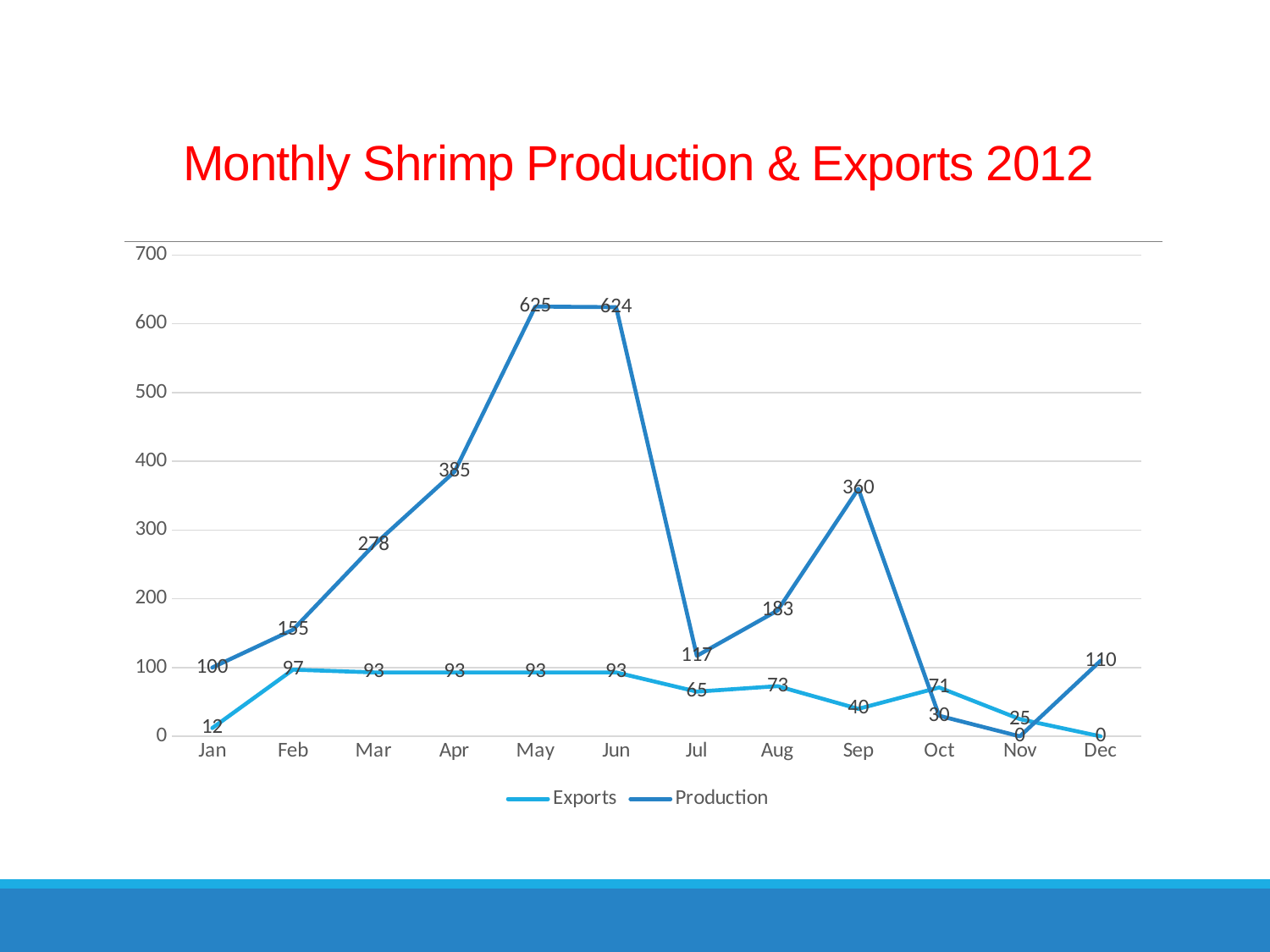
What is the Production value for May? 625 What is the Production value for December? 110 In October, which series has the larger value, Exports or Production? Exports In which month is Production lowest? Nov What kind of chart is shown on the slide? line chart What is the difference between Production in June and Production in July? 507 What is the difference between Production in May and Production in April? 240 What is the Exports value for September? 40 Is the Production value for April greater or less than 300? greater How many series does the legend list? 2 In which month is Exports lowest? Dec How many months are shown on the x axis? 12